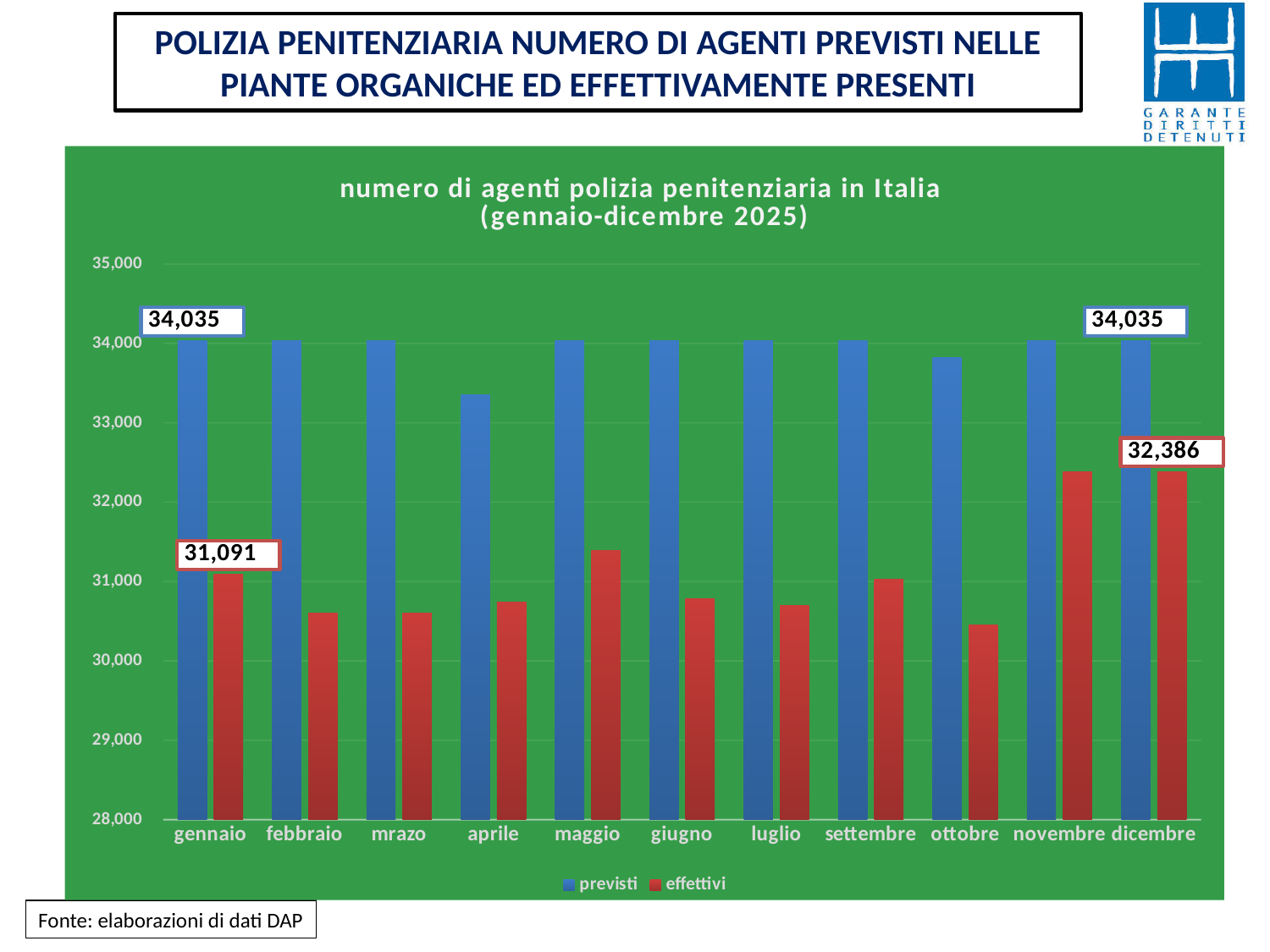
What is the value of the previsti series for gennaio? 34,035 How many months are shown on the x axis? 11 Is the previsti value for aprile greater or less than 34,000? less What is the value of the effettivi series for gennaio? 31,091 What is the value of the previsti series for dicembre? 34,035 By how much did the effettivi value increase from gennaio to dicembre? 1,295 What kind of chart is shown on the slide? bar chart Which month has the highest effettivi value? novembre and dicembre (tied) What is the difference between previsti and effettivi for dicembre? 1,649 How many series does the legend list? 2 What is the value of the effettivi series for dicembre? 32,386 Is the effettivi value for febbraio greater or less than 31,000? less